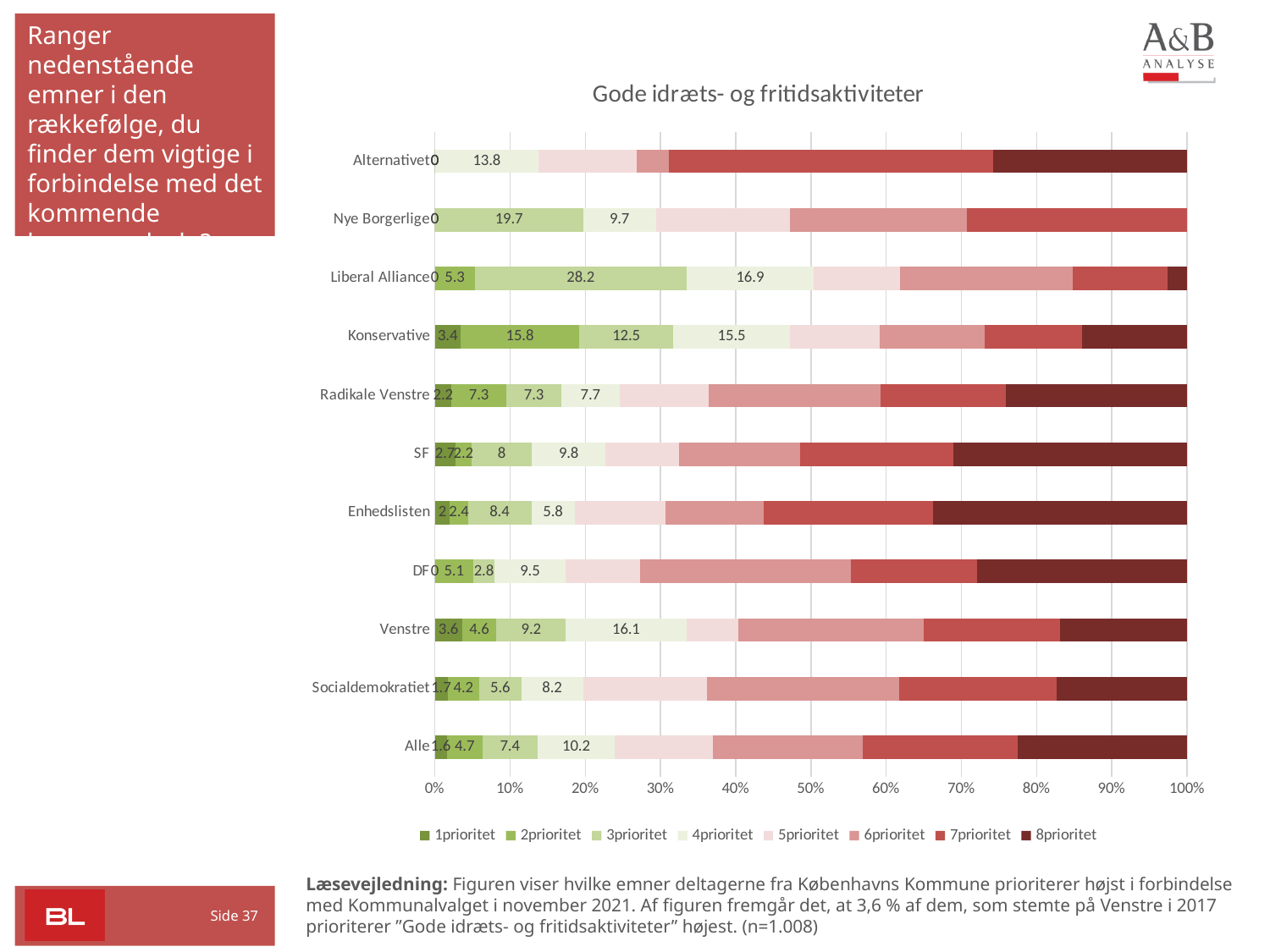
How many series does the legend list? 8 What is the 4prioritet value for Alle? 10.2 What is the 3prioritet value for Liberal Alliance? 28.2 What is the difference between the 2prioritet values for Konservative and Venstre? 11.2 Which category has the highest 3prioritet value? Liberal Alliance What is the title of the chart? Gode idræts- og fritidsaktiviteter What is the 2prioritet value for Nye Borgerlige? 0 What is the 1prioritet value for Venstre? 3.6 What is the 1prioritet value for SF? 2.7 How many categories (parties/groups) are shown on the y axis of the chart? 11 What kind of chart is shown on the slide? bar chart Which has the larger 4prioritet value, Venstre or Konservative? Venstre